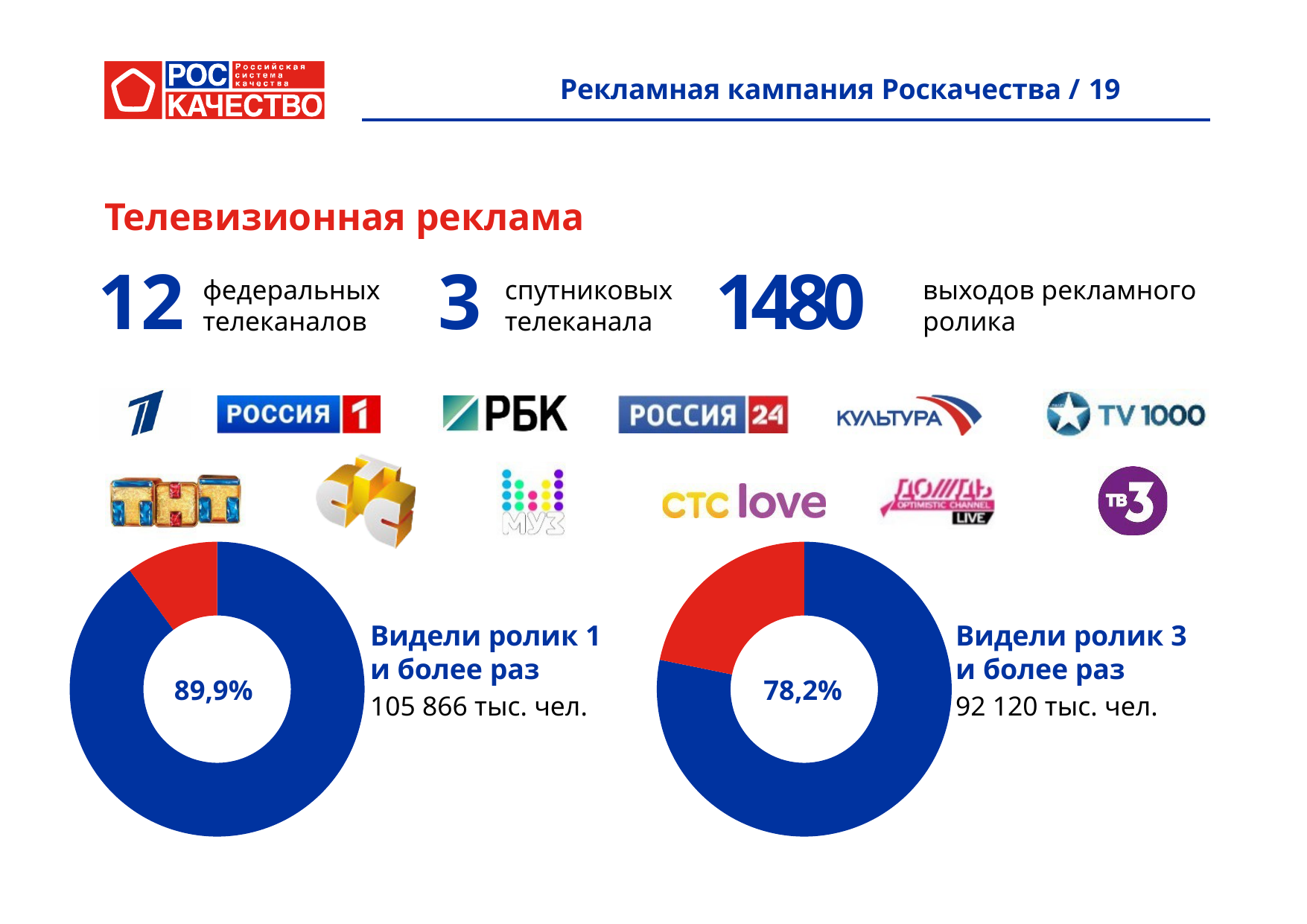
What is the difference in percentage points between the share in the left donut chart (89,9%) and the share in the right donut chart (78,2%)? 11,7 percentage points In the left donut chart, what colour is the slice representing 89,9%? Blue How many slices does the right donut chart have? 2 What kind of chart is used on the left side of the slide to show the share of people who saw the ad 1 or more times? Donut (pie) chart In the right donut chart, what colour is the smaller slice? Red How many slices does the left donut chart have? 2 In the left donut chart, what share of people saw the ad 1 or more times (Видели ролик 1 и более раз)? 89,9% Which is larger: the share shown in the left donut chart (1 or more views) or the share shown in the right donut chart (3 or more views)? The left chart (89,9%) In the right donut chart, what share of people saw the ad 3 or more times (Видели ролик 3 и более раз)? 78,2% According to the right chart's caption, how many people (тыс. чел.) saw the ad 3 or more times? 92 120 тыс. чел. What is the difference between the number of people who saw the ad 1 or more times (105 866 тыс. чел.) and 3 or more times (92 120 тыс. чел.)? 13 746 тыс. чел. According to the left chart's caption, how many people (тыс. чел.) saw the ad 1 or more times? 105 866 тыс. чел.